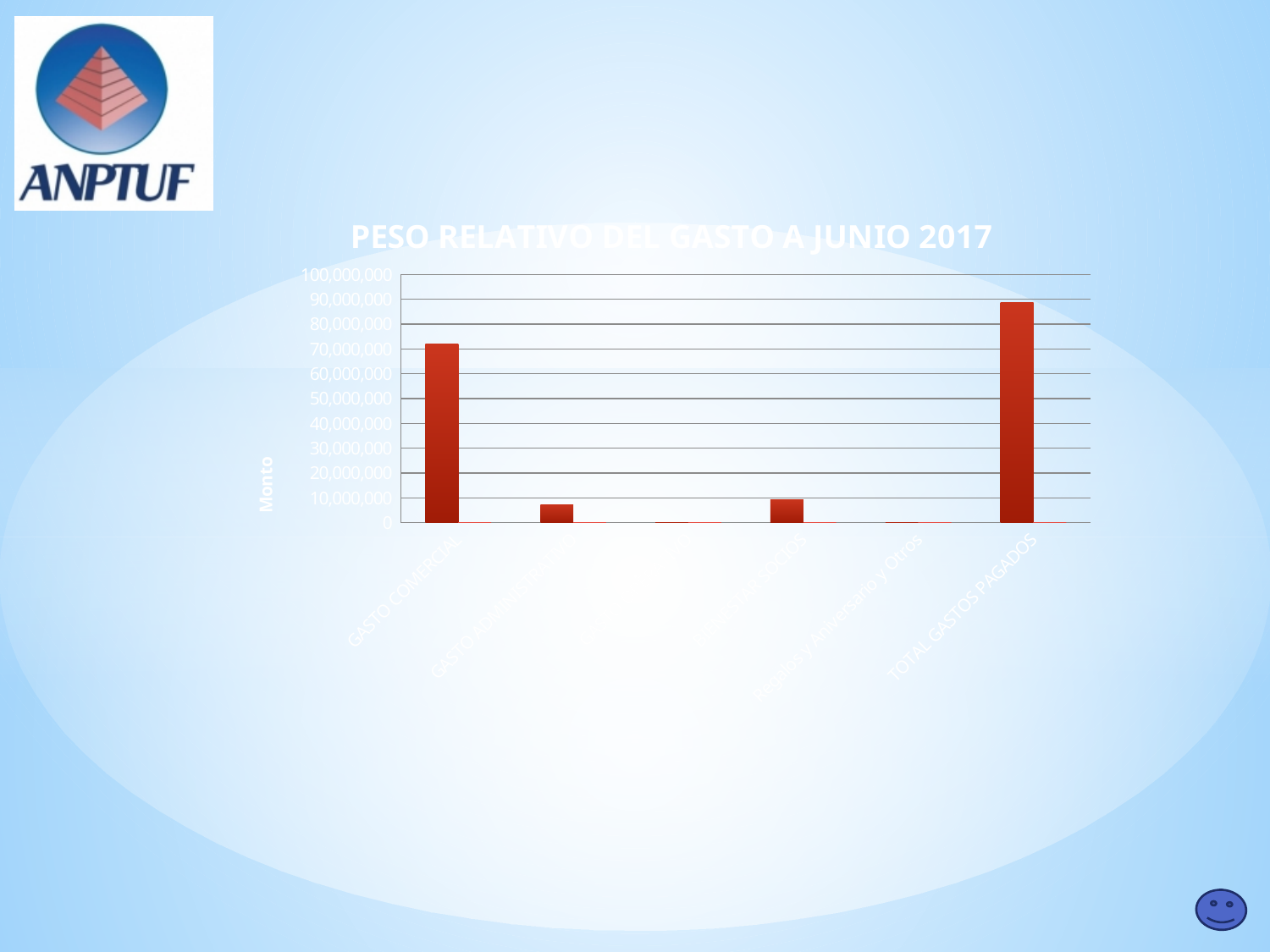
Is the value for TOTAL GASTOS PAGADOS greater or less than 80,000,000? greater What is the title of the chart? PESO RELATIVO DEL GASTO A JUNIO 2017 Is the value for TOTAL GASTOS PAGADOS greater or less than 100,000,000? less Is the value for GASTO COMERCIAL greater or less than 80,000,000? less Which is larger, the value for GASTO COMERCIAL or the value for TOTAL GASTOS PAGADOS? TOTAL GASTOS PAGADOS Which is larger, the value for GASTO COMERCIAL or the value for Regalos y Aniversario y Otros? GASTO COMERCIAL What kind of chart is shown on the slide? bar chart How many bars are plotted in the chart? 6 What is the label on the vertical axis of the chart? Monto Which category has the highest value in the chart? TOTAL GASTOS PAGADOS